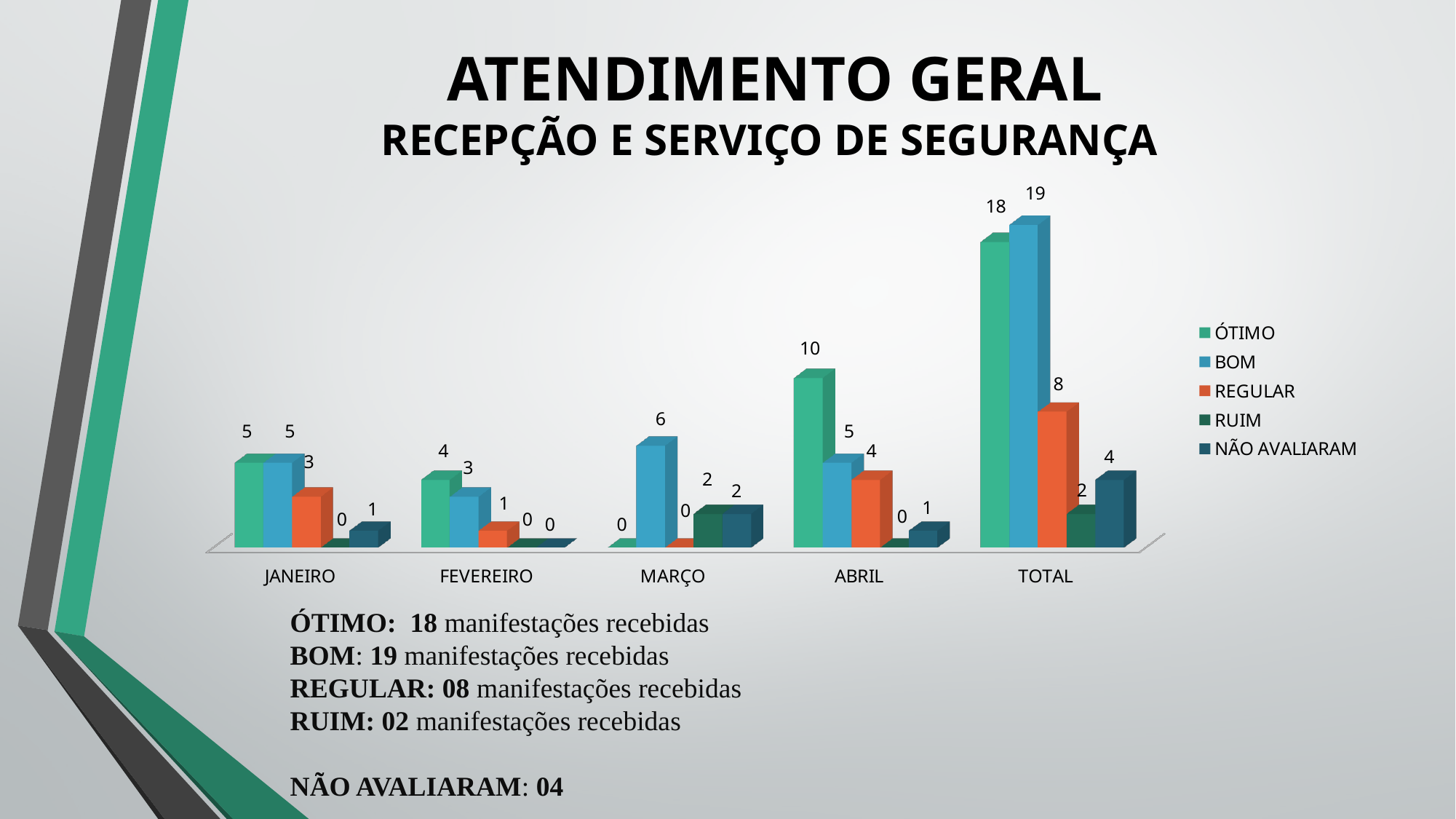
Which series is shown in orange in the legend? REGULAR What is the value of ÓTIMO for ABRIL? 10 How many categories are shown on the x axis? 5 Which series has the highest value in the TOTAL category? BOM Which month has the lowest value for ÓTIMO? MARÇO What is the value of BOM for MARÇO? 6 What is the value of REGULAR for TOTAL? 8 What is the difference between the TOTAL values for ÓTIMO and REGULAR? 10 Which is larger: ÓTIMO for FEVEREIRO or BOM for FEVEREIRO? ÓTIMO for FEVEREIRO What kind of chart is shown on the slide? Bar chart What is the value of NÃO AVALIARAM for JANEIRO? 1 How many series does the legend list? 5